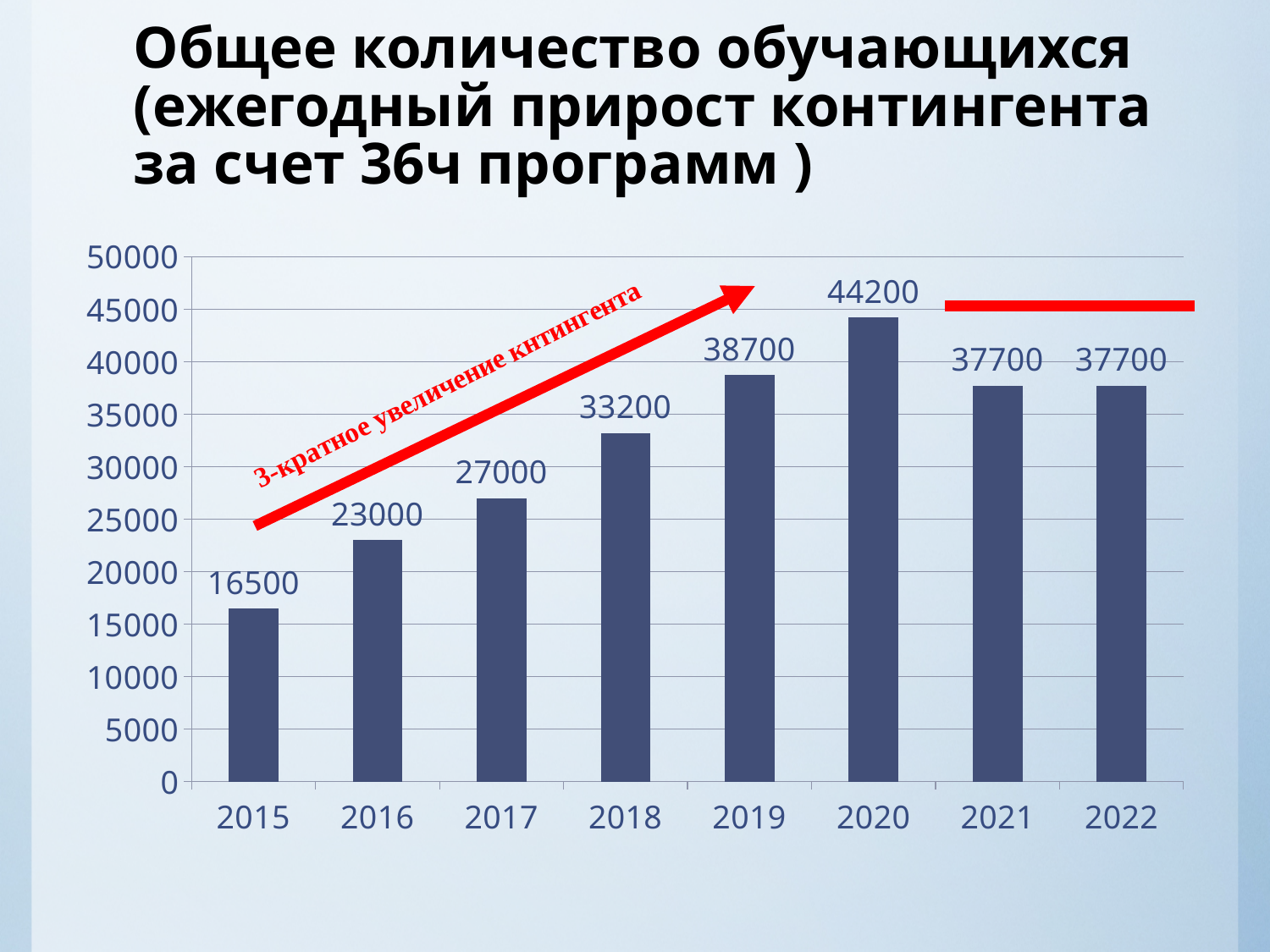
Which year has the highest value? 2020 How many years are shown on the x axis? 8 What is the value for 2020? 44200 What kind of chart is shown on the slide? bar chart Do the values rise or fall from 2015 to 2020? rise Is the value for 2016 greater or less than 25000? less What is the difference between the values for 2017 and 2015? 10500 What is the value for 2015? 16500 What is the difference between the values for 2020 and 2019? 5500 Which is larger, the value for 2019 or the value for 2021? 2019 What is the value for 2018? 33200 Which year has the lowest value? 2015